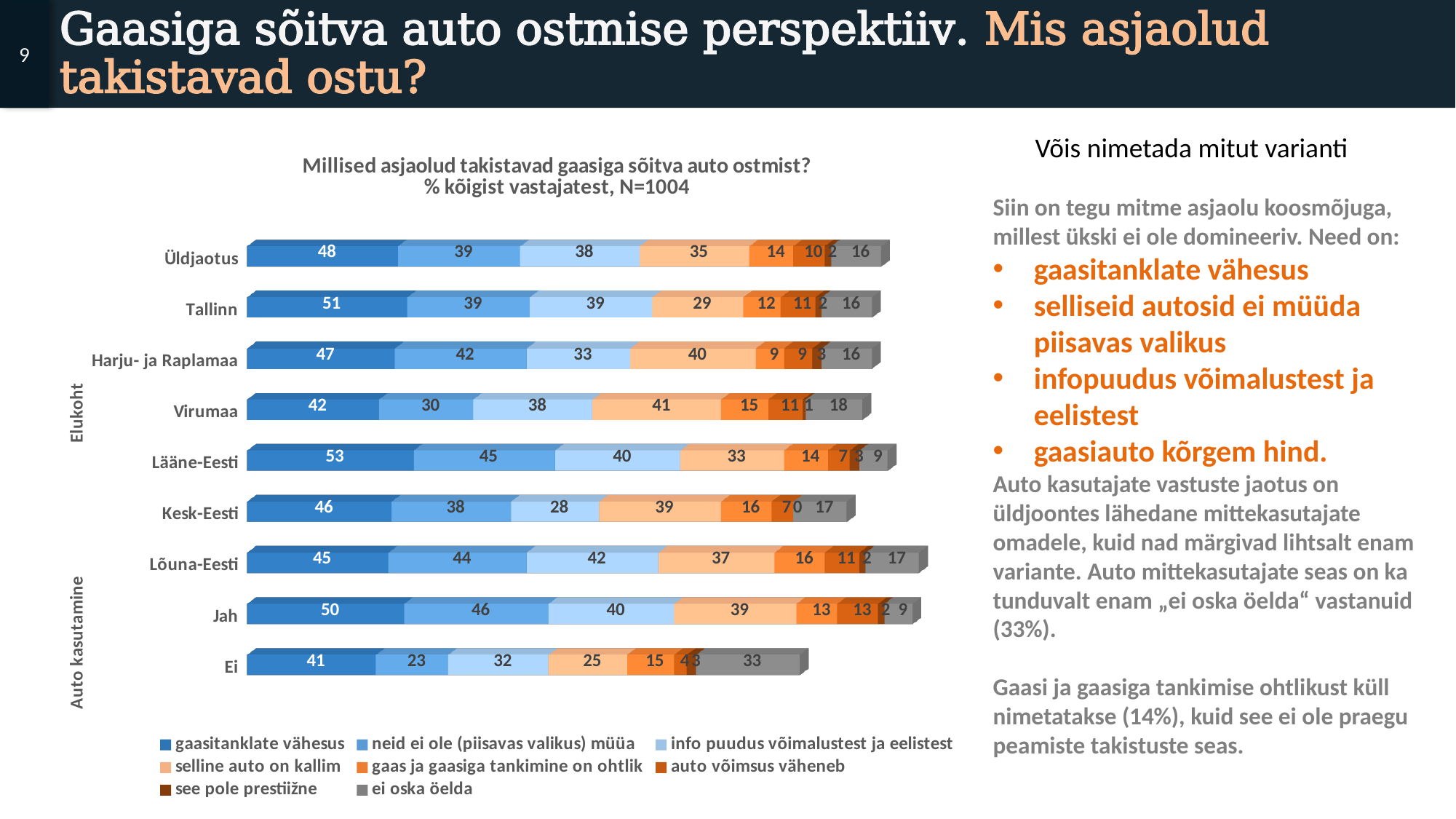
Which is larger: the 'neid ei ole (piisavas valikus) müüa' value for Jah or for Ei? Jah What is the difference between the 'gaasitanklate vähesus' values for Tallinn and Virumaa? 9 What is the value for 'selline auto on kallim' in the Virumaa row? 41 Which category has the highest value for 'gaasitanklate vähesus'? Lääne-Eesti What kind of chart is shown on the slide? Stacked bar chart What is the value for 'ei oska öelda' in the Ei row? 33 What is the value for 'gaasitanklate vähesus' in the Üldjaotus row? 48 Which category has the lowest value for 'gaasitanklate vähesus'? Ei How many series does the legend list? 8 Which category has the highest value for 'ei oska öelda'? Ei What is the title of the chart? Millised asjaolud takistavad gaasiga sõitva auto ostmist? % kõigist vastajatest, N=1004 How many categories (rows) are plotted in the chart? 9